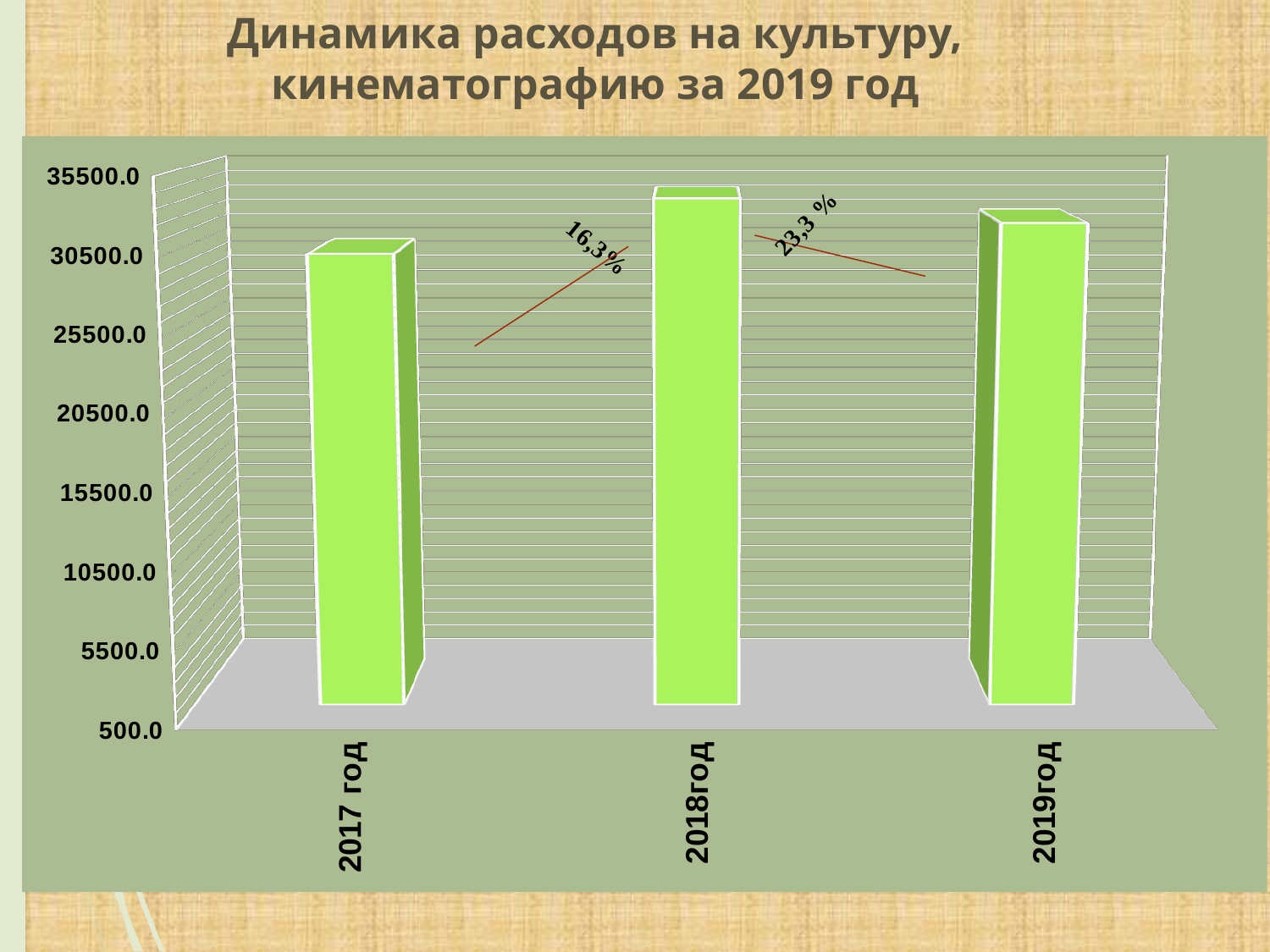
Is the value for 2018год greater or less than 35500.0? less How many categories (years) are plotted on the chart? 3 What kind of chart is shown on the slide? bar chart Is the value for 2017 год greater or less than 25500.0? greater What percentage is written on the annotation between the 2017 год and 2018год bars? 16,3% What is the title of the chart on the slide? Динамика расходов на культуру, кинематографию за 2019 год Which year has the highest bar? 2018год Which year has the lowest bar? 2017 год Is the value for 2019год greater or less than 30500.0? greater Which bar is taller, 2018год or 2019год? 2018год Which bar is taller, 2017 год or 2019год? 2019год